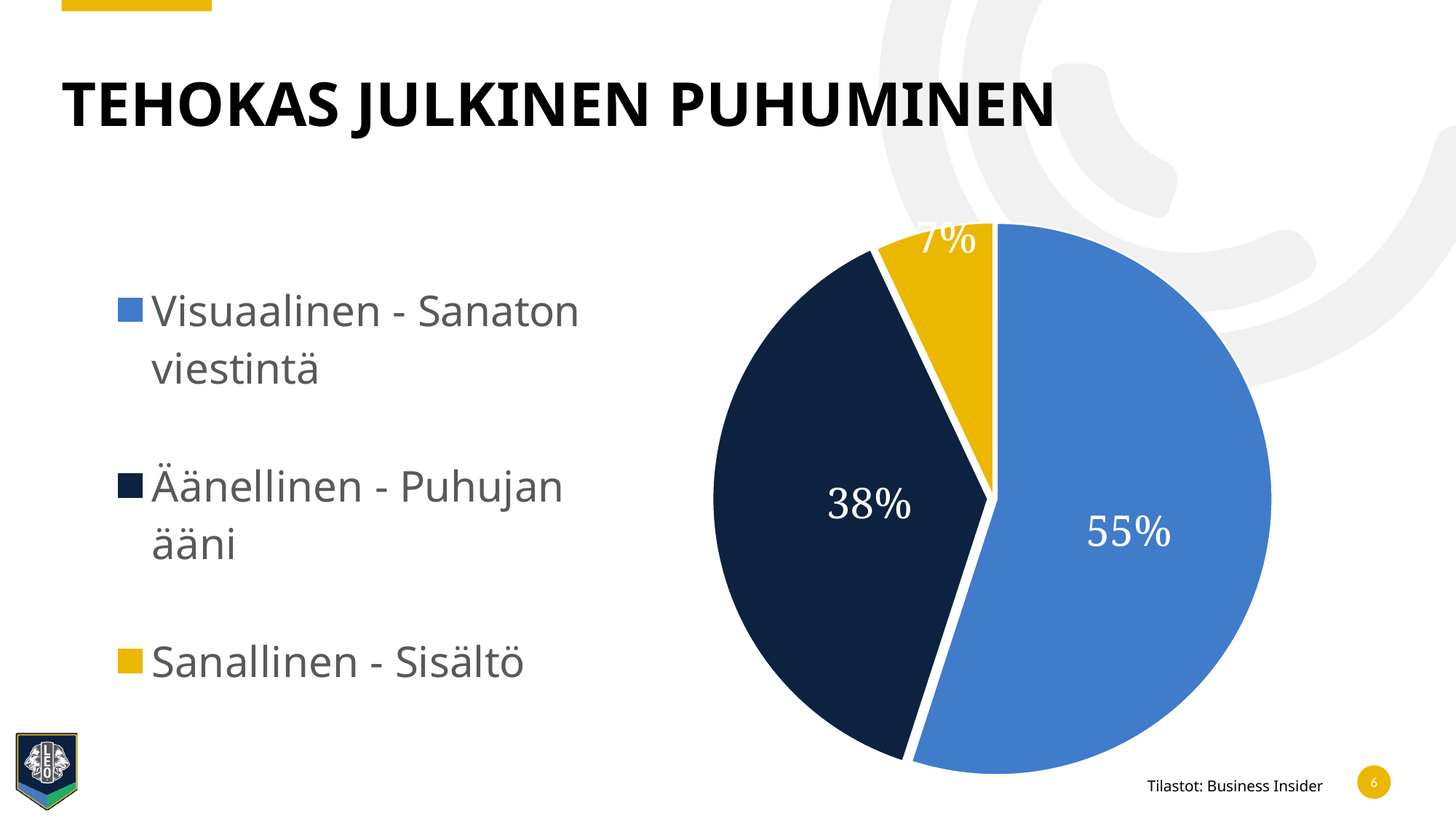
What is the difference in percentage points between "Äänellinen - Puhujan ääni" and "Sanallinen - Sisältö"? 31 percentage points Which category has the largest slice of the pie? Visuaalinen - Sanaton viestintä What kind of chart is shown on the slide? Pie chart What is the title of the slide containing the chart? TEHOKAS JULKINEN PUHUMINEN Which category has the smallest slice of the pie? Sanallinen - Sisältö What is the difference in percentage points between "Visuaalinen - Sanaton viestintä" and "Äänellinen - Puhujan ääni"? 17 percentage points What share of the pie does "Äänellinen - Puhujan ääni" have? 38% What share of the pie does "Sanallinen - Sisältö" have? 7% Which is larger, the slice for "Äänellinen - Puhujan ääni" or the slice for "Sanallinen - Sisältö"? Äänellinen - Puhujan ääni How many slices does the pie chart have? 3 What share of the pie does "Visuaalinen - Sanaton viestintä" have? 55% What colour is the slice for "Sanallinen - Sisältö"? Yellow